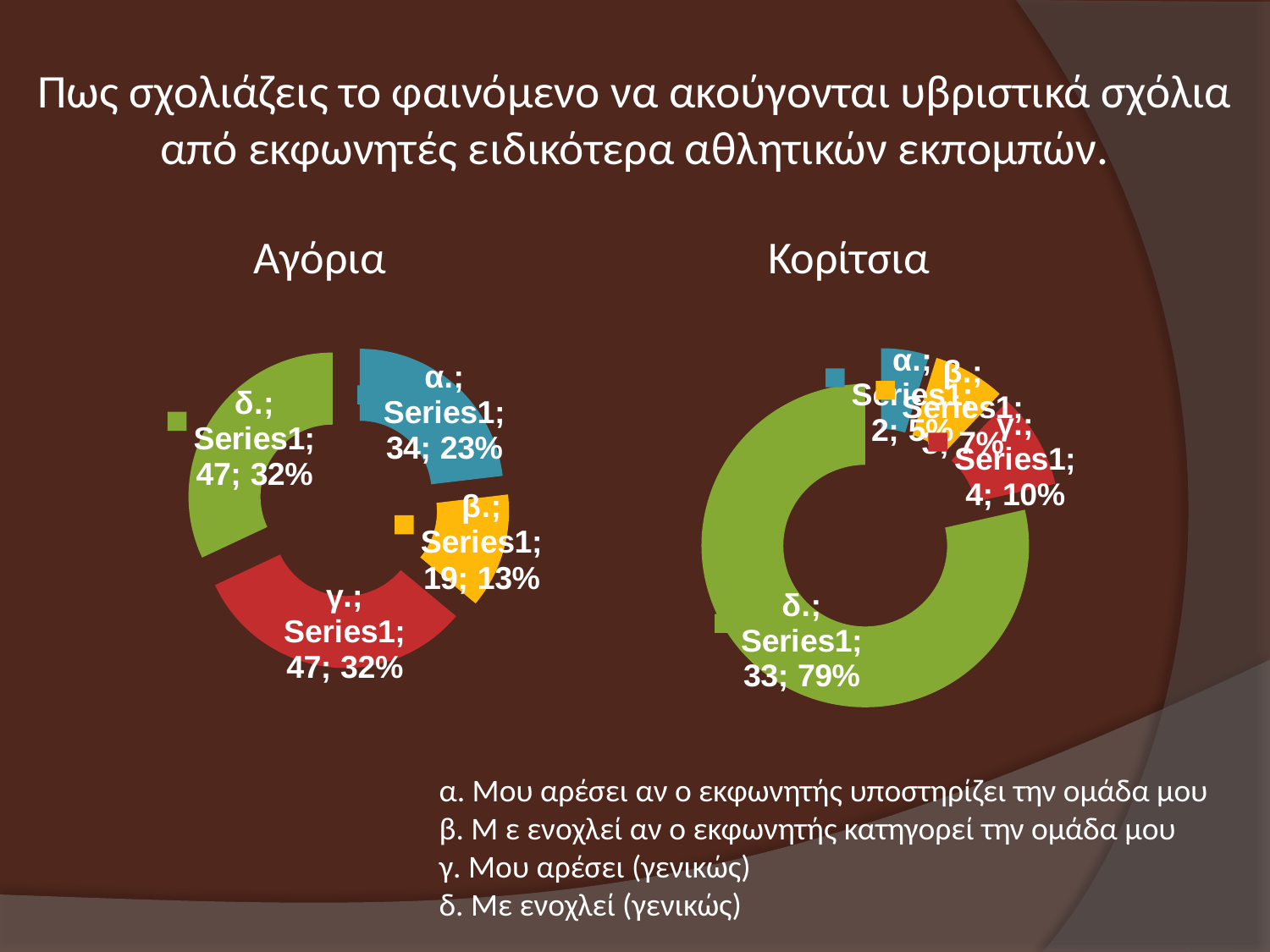
In the Αγόρια chart, what value is shown for category α? 34; 23% In the Κορίτσια chart, which category has the largest slice? δ In the Κορίτσια chart, what value is shown for category δ? 33; 79% How many charts are shown on the slide? 2 In the Κορίτσια chart, what share of the total does category δ represent? 79% In the Αγόρια chart, what is the difference between the counts for γ and β? 28 What kind of chart is used on this slide? Doughnut (pie) chart In the Αγόρια chart, which is larger, the value for α or the value for β? α In the Αγόρια chart, what value is shown for category β? 19; 13% How many slices does the Αγόρια chart have? 4 In the Κορίτσια chart, what value is shown for category γ? 4; 10% In the Αγόρια chart, which category has the smallest slice? β